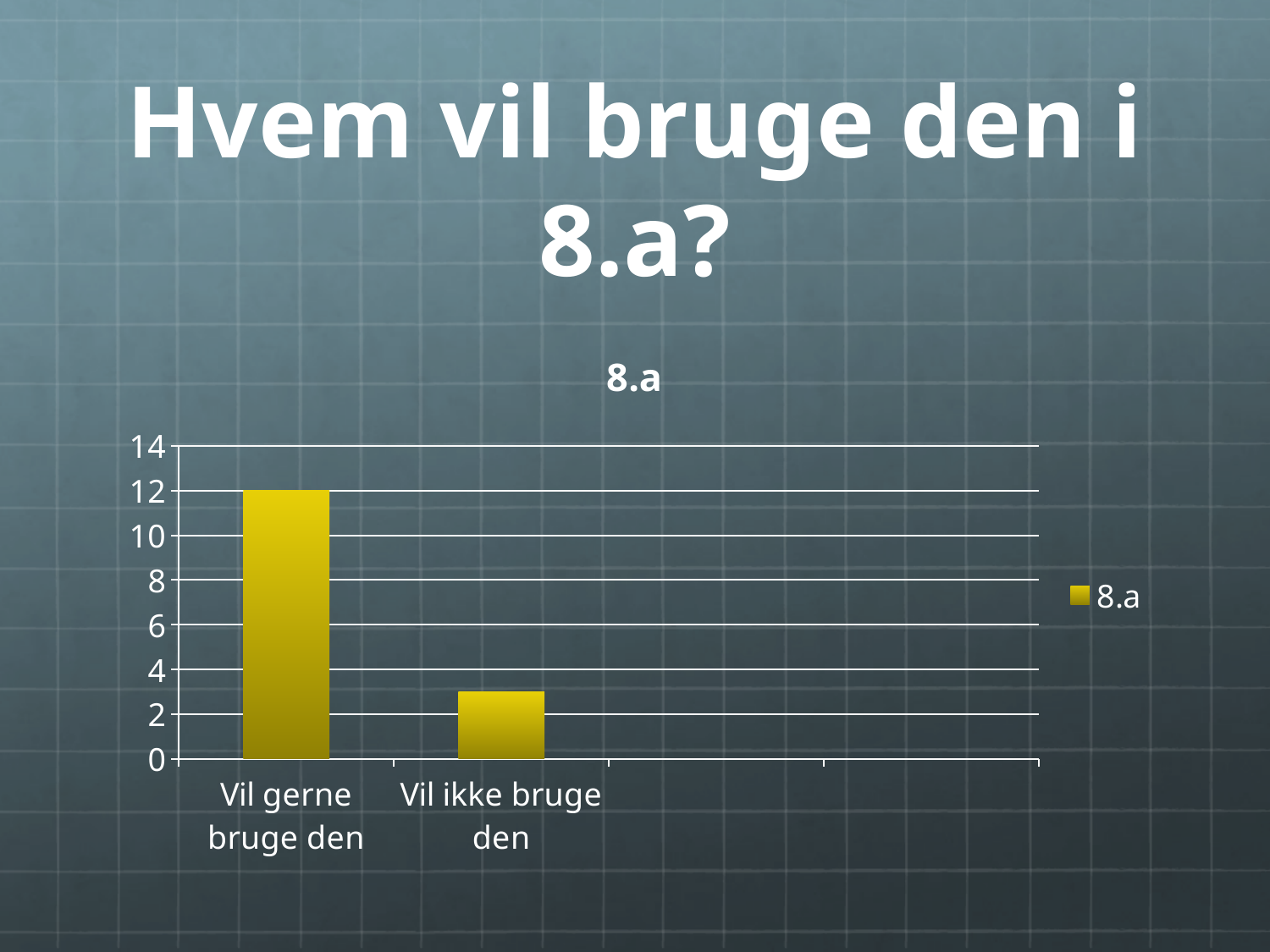
How many series does the legend list? 1 What is the value for "Vil gerne bruge den"? 12 What kind of chart is shown on the slide? bar chart Which is larger, the value for "Vil gerne bruge den" or the value for "Vil ikke bruge den"? Vil gerne bruge den Is the value for "Vil ikke bruge den" greater or less than 4? less Is the value for "Vil ikke bruge den" greater or less than 2? greater What is the title of the chart? 8.a Do the values rise or fall from left to right along the x axis? fall Is the value for "Vil gerne bruge den" greater or less than 10? greater Which category has the lowest value? Vil ikke bruge den How many categories are shown on the x axis? 2 Which category has the highest value? Vil gerne bruge den